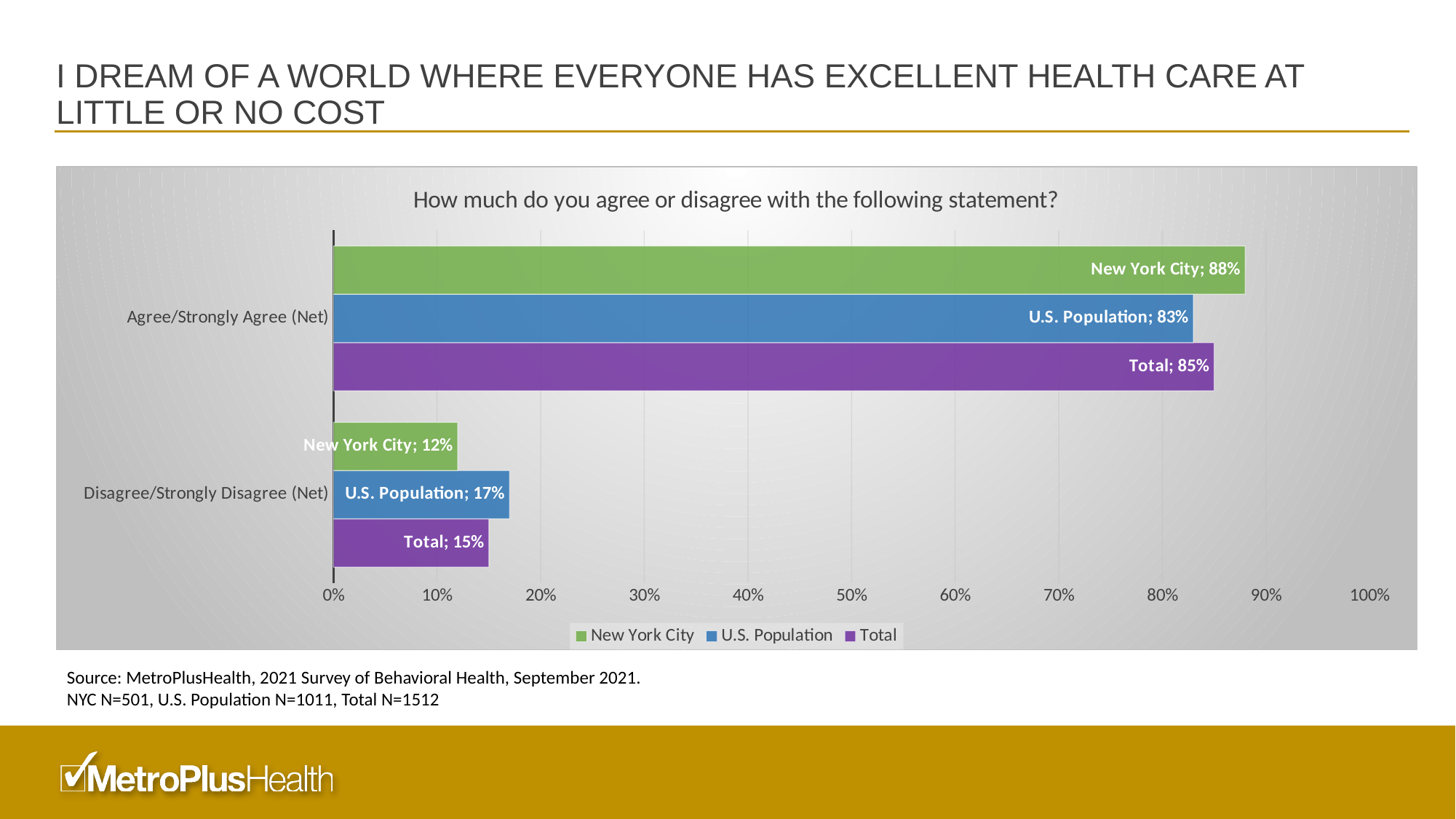
Is the Total value for Agree/Strongly Agree (Net) greater or less than 80%? greater What is the Total value for Agree/Strongly Agree (Net)? 85% What kind of chart is shown on the slide? Bar chart How many series does the legend list? 3 Which is larger for Disagree/Strongly Disagree (Net): the U.S. Population value or the Total value? U.S. Population What is the U.S. Population value for Disagree/Strongly Disagree (Net)? 17% Which series has the lowest value for Disagree/Strongly Disagree (Net)? New York City What is the difference between the New York City and U.S. Population values for Agree/Strongly Agree (Net)? 5% What percentage of New York City respondents agree or strongly agree (net) with the statement? 88% What is the difference between the U.S. Population and Total values for Disagree/Strongly Disagree (Net)? 2% What is the title of the chart? How much do you agree or disagree with the following statement? Which series has the highest value for Agree/Strongly Agree (Net)? New York City